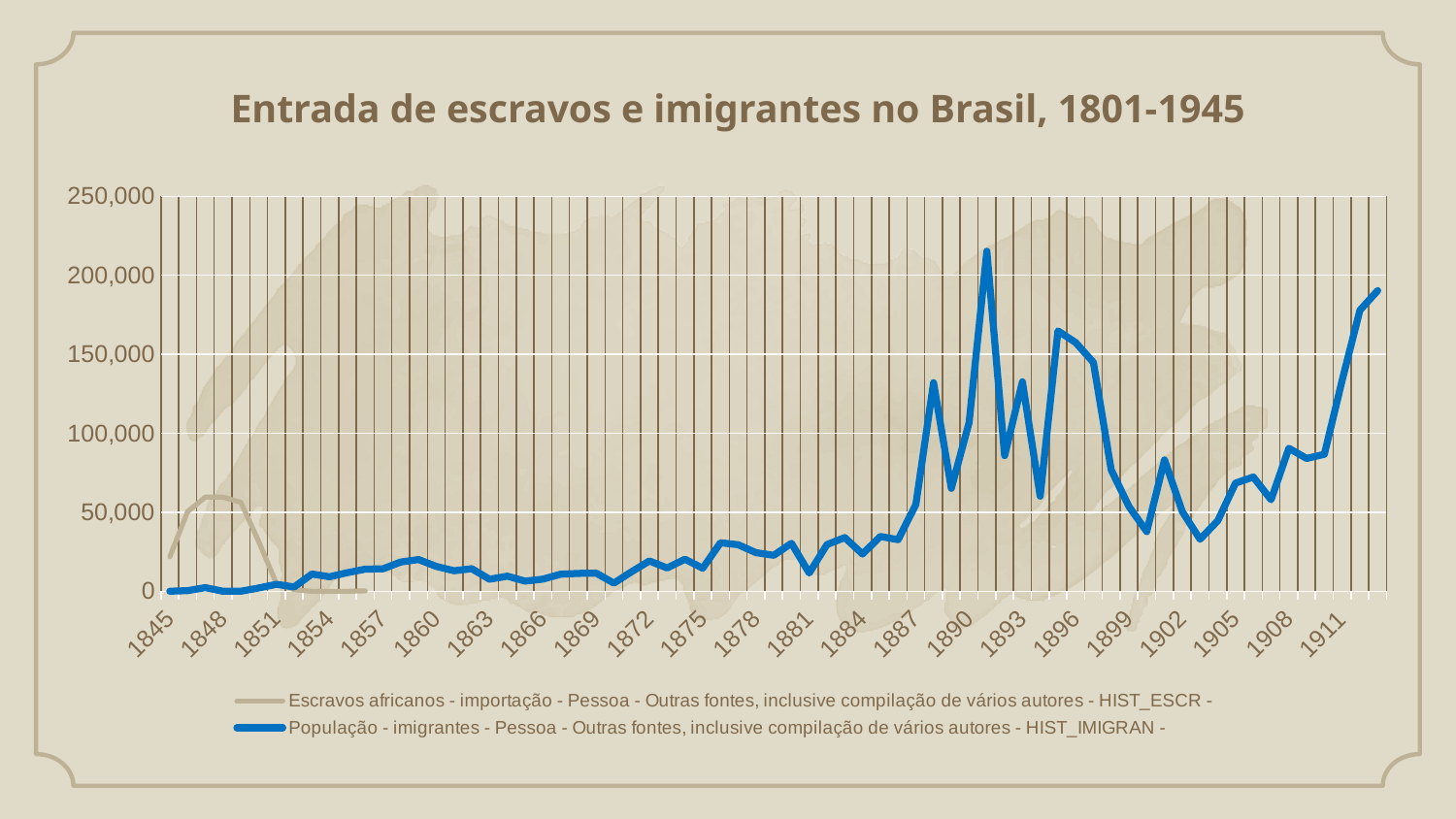
Is the value of the immigrant series (blue line) in 1860 greater or less than 50,000? less How many year labels are shown on the x axis? 23 Is the value of the immigrant series (blue line) in 1893 greater or less than 100,000? greater What kind of chart is shown on the slide? line chart How many series does the legend list? 2 Is the peak value of the African slaves series (grey line) greater or less than 50,000? greater Does the immigrant series (blue line) generally rise or fall from 1845 to the end of the x axis? rise Which is larger for the immigrant series (blue line): the value in 1893 or the value in 1860? 1893 What is the title of the chart? Entrada de escravos e imigrantes no Brasil, 1801-1945 What colour is the line for the immigrant population series (HIST_IMIGRAN)? blue